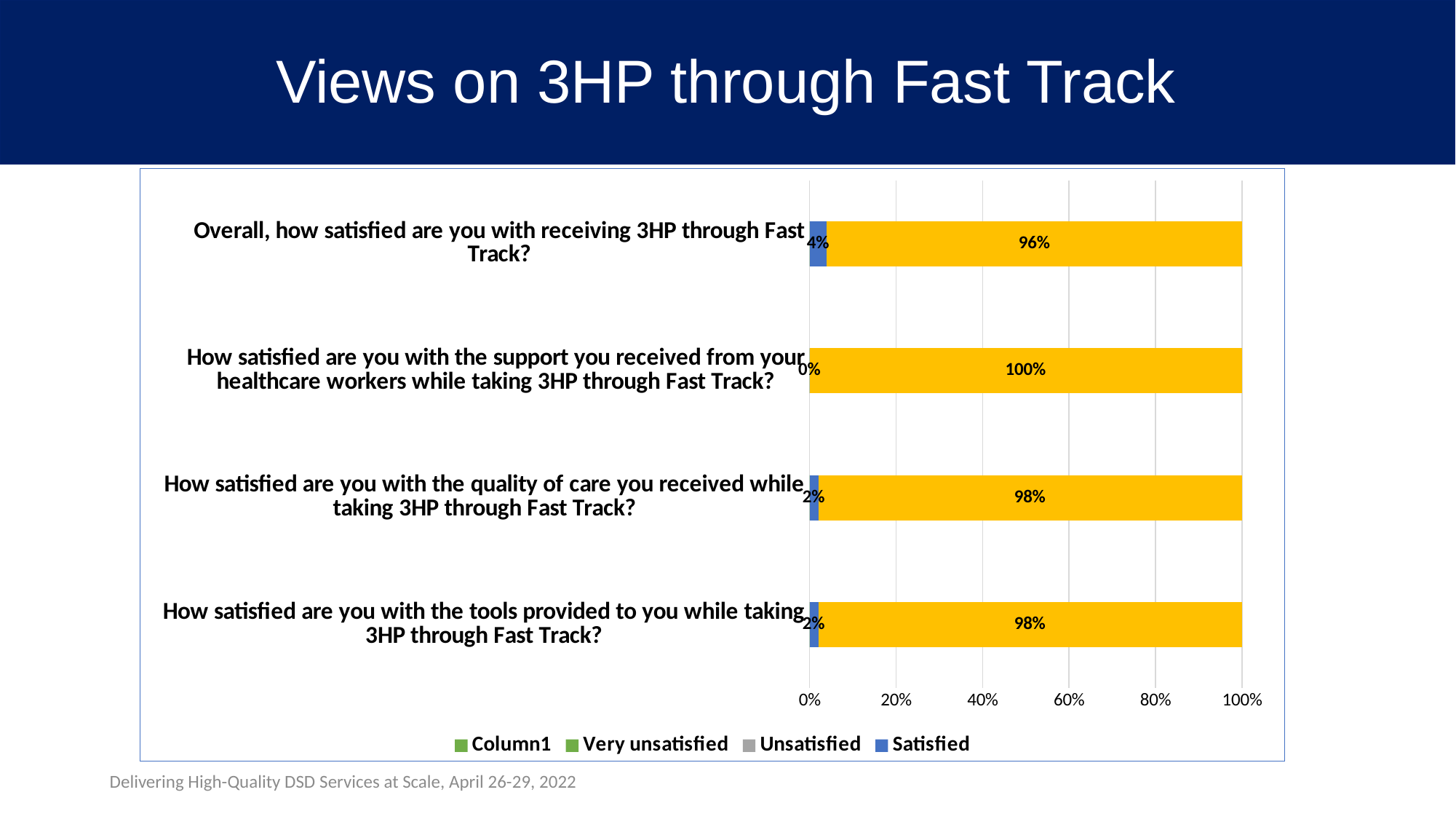
What is the value of the yellow segment for the question about the quality of care received? 98% What is the total of the stacked bar for the question about the tools provided? 100% How many survey questions (categories) are plotted in the chart? 4 Which survey question has the highest 'Satisfied' value? Overall, how satisfied are you with receiving 3HP through Fast Track? What is the 'Satisfied' value for 'Overall, how satisfied are you with receiving 3HP through Fast Track?' 4% What is the value of the yellow segment for the question about the tools provided? 98% How many series does the chart legend list? 4 Which survey question has the lowest yellow-segment value? Overall, how satisfied are you with receiving 3HP through Fast Track? What is the 'Satisfied' value for the question about support received from healthcare workers? 0% What kind of chart is shown on the slide? Stacked bar chart Which is larger: the yellow segment for the healthcare worker support question or the yellow segment for the overall satisfaction question? The healthcare worker support question What is the difference between the 'Satisfied' value for the overall satisfaction question and the 'Satisfied' value for the quality of care question? 2 percentage points